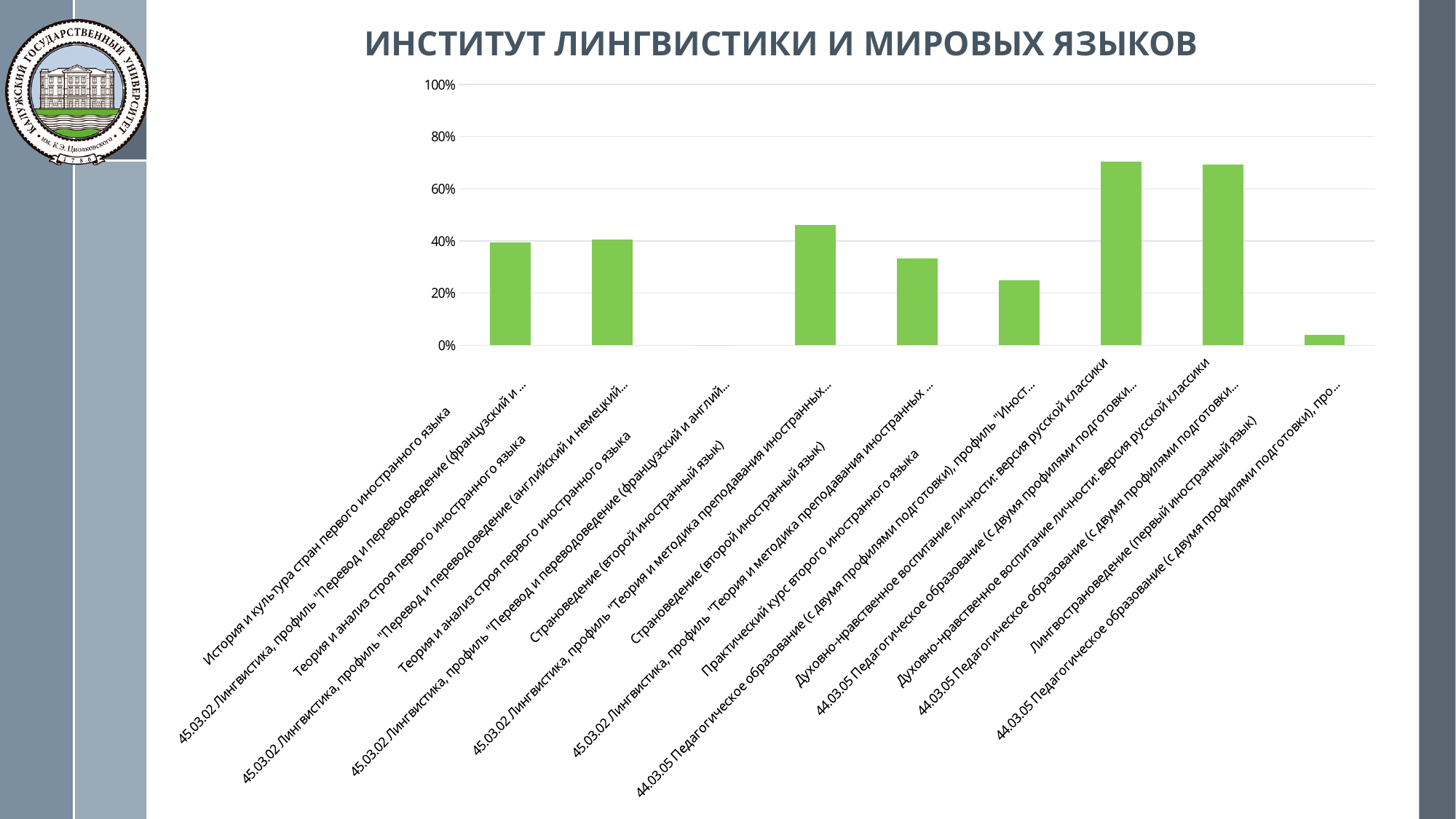
Is the value for Лингвострановедение (первый иностранный язык) greater or less than 20%? less How many bars are actually drawn in the chart? 8 Which is larger: the value for История и культура стран первого иностранного языка or the value for Практический курс второго иностранного языка? История и культура стран первого иностранного языка What kind of chart is shown on the slide? bar chart Is the value for История и культура стран первого иностранного языка greater or less than 20%? greater What colour are the bars in the chart? green Is the value for the rightmost bar labelled Духовно-нравственное воспитание личности: версия русской классики greater or less than 60%? greater How many categories are labelled on the x axis of the chart? 9 Among the bars drawn, which category has the shortest bar? Лингвострановедение (первый иностранный язык) Which is larger: the value for Практический курс второго иностранного языка or the value for Лингвострановедение (первый иностранный язык)? Практический курс второго иностранного языка What is the title of the slide containing the chart? ИНСТИТУТ ЛИНГВИСТИКИ И МИРОВЫХ ЯЗЫКОВ